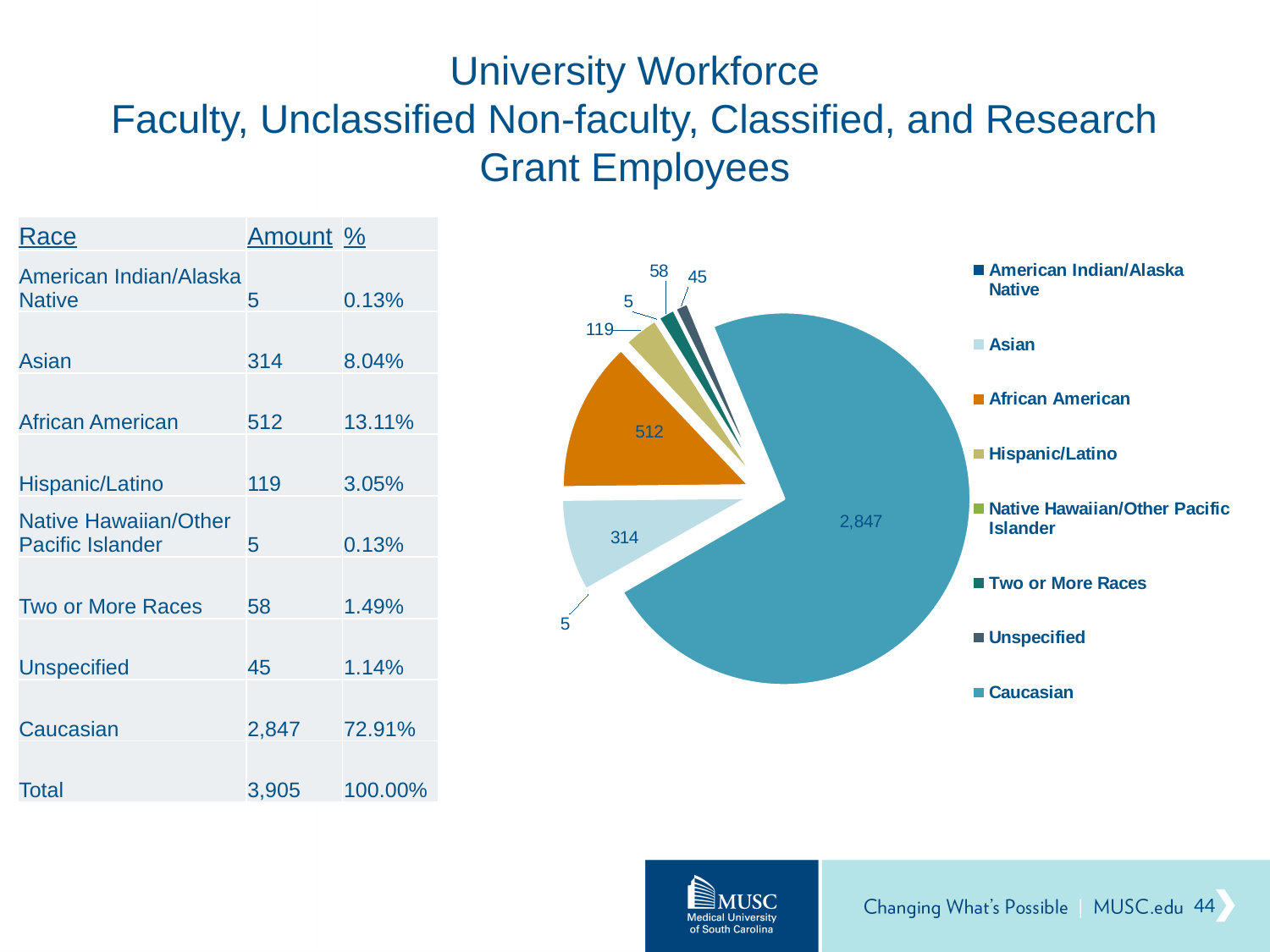
What is the value of the African American slice in the pie chart? 512 What is the difference between the Two or More Races and Unspecified values in the pie chart? 13 Which category has the largest slice in the pie chart? Caucasian What share of the pie does the Caucasian slice represent? 72.91% How many slices does the pie chart have? 8 What is the difference between the African American and Asian values in the pie chart? 198 Which category is larger in the pie chart, African American or Asian? African American What is the value of the Hispanic/Latino slice in the pie chart? 119 What type of chart is shown on the slide? pie chart How many entries does the pie chart's legend list? 8 What is the value of the Asian slice in the pie chart? 314 What is the value of the Caucasian slice in the pie chart? 2,847